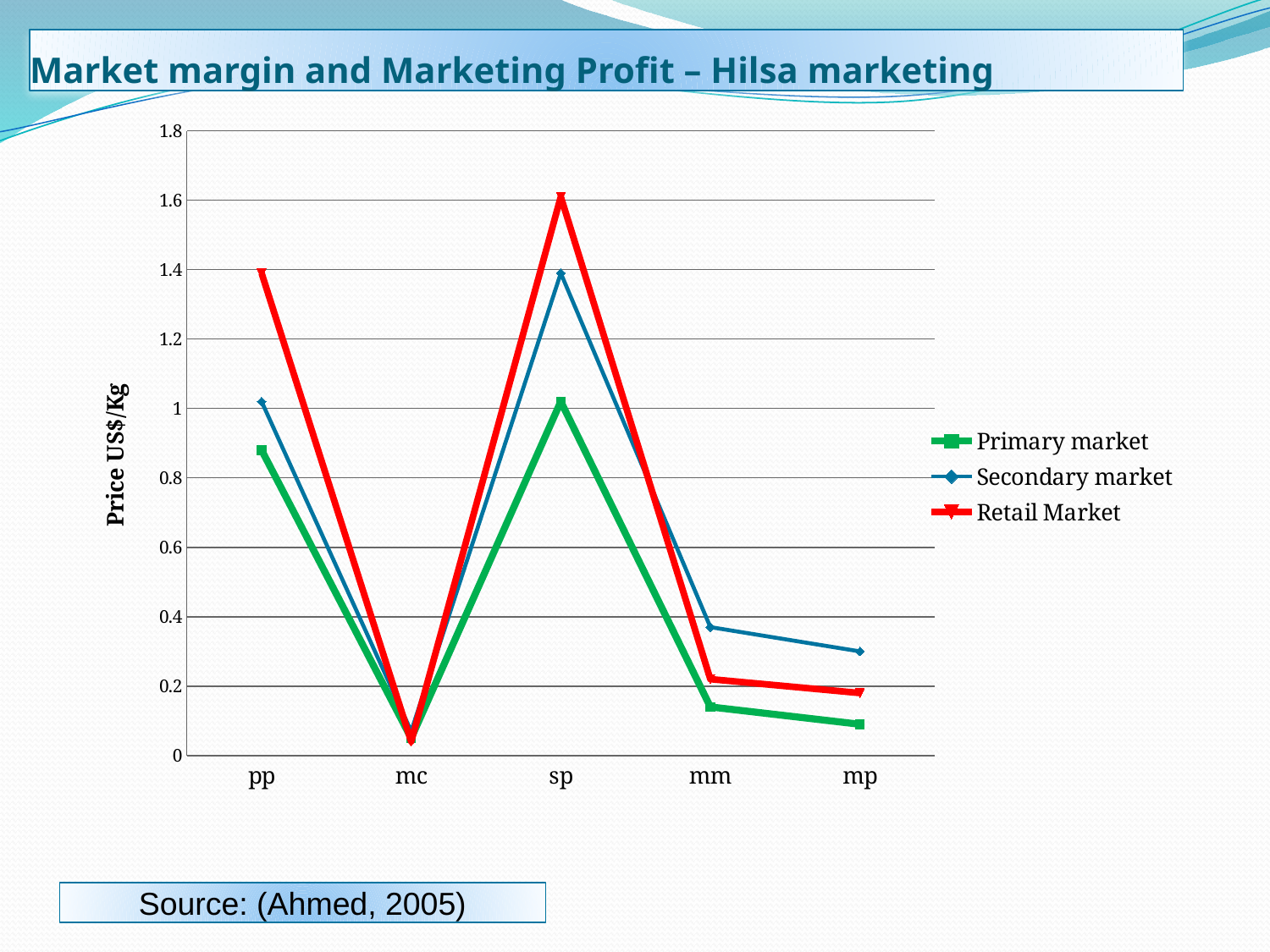
Which series has the highest value at sp? Retail Market How many categories are shown on the x axis? 5 What is the label on the y axis? Price US$/Kg Is the Retail Market value at sp greater or less than 1.4? greater Does the Secondary market series rise or fall from mm to mp? fall At which category does the Retail Market series reach its highest value? sp What kind of chart is shown on the slide? line chart At mm, which is larger: the Secondary market value or the Retail Market value? Secondary market At which category does the Primary market series reach its lowest value? mc Is the Secondary market value at sp greater or less than 1.2? greater Is the Primary market value at pp greater or less than 1? less How many series does the legend list? 3